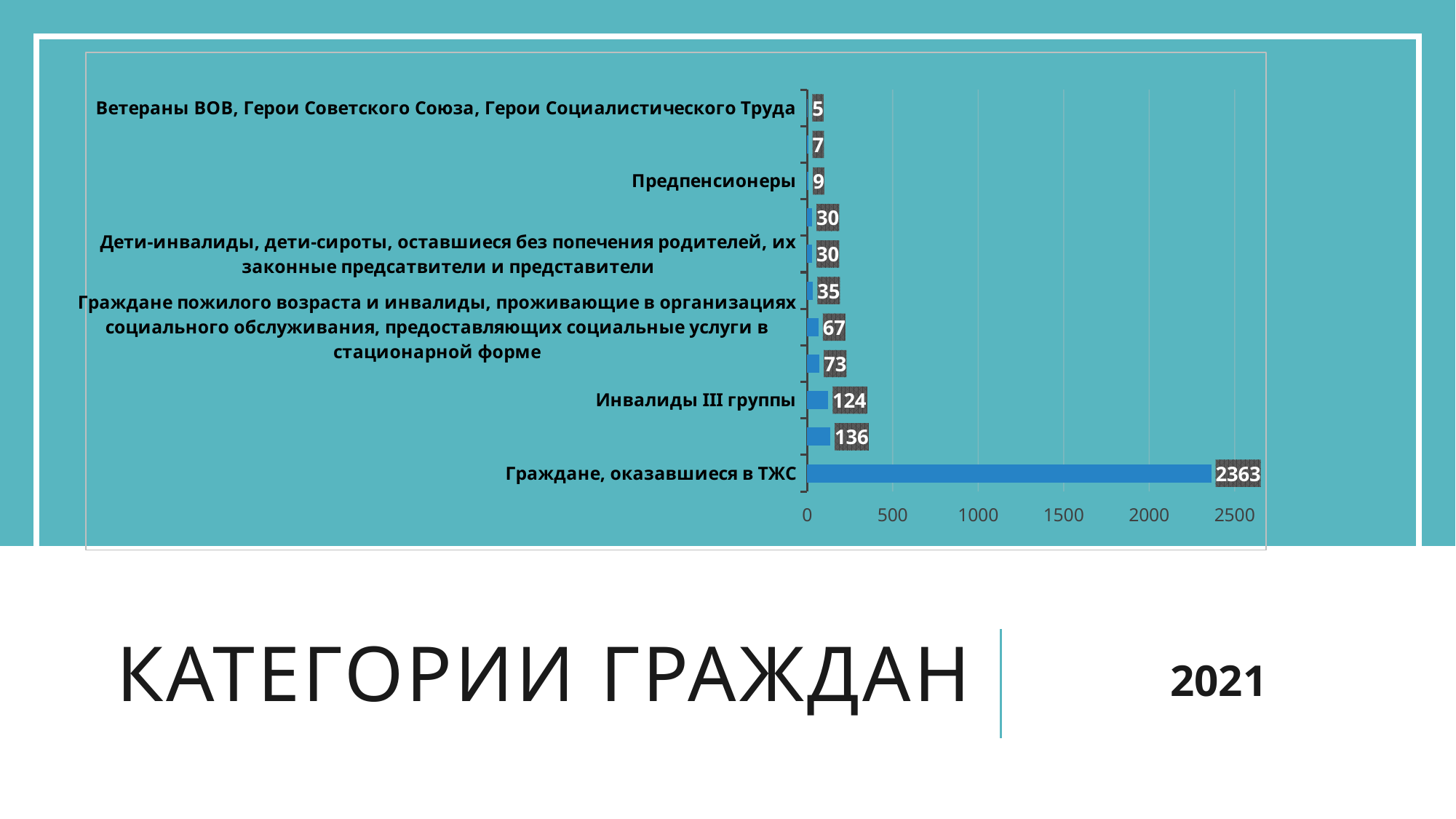
What kind of chart is shown on the slide? bar chart What is the value for "Инвалиды III группы"? 124 What is the value for "Граждане пожилого возраста и инвалиды, проживающие в организациях социального обслуживания, предоставляющих социальные услуги в стационарной форме"? 67 Is the value for "Граждане, оказавшиеся в ТЖС" greater or less than 2000? greater Which is larger: the value for "Инвалиды III группы" or the value for "Предпенсионеры"? Инвалиды III группы What is the value for "Предпенсионеры"? 9 Which category has the highest value? Граждане, оказавшиеся в ТЖС What is the value for "Граждане, оказавшиеся в ТЖС"? 2363 What is the value for "Ветераны ВОВ, Герои Советского Союза, Герои Социалистического Труда"? 5 How many bars are plotted in the chart? 11 What is the difference between the values for "Инвалиды III группы" and "Предпенсионеры"? 115 Which category has the lowest value? Ветераны ВОВ, Герои Советского Союза, Герои Социалистического Труда